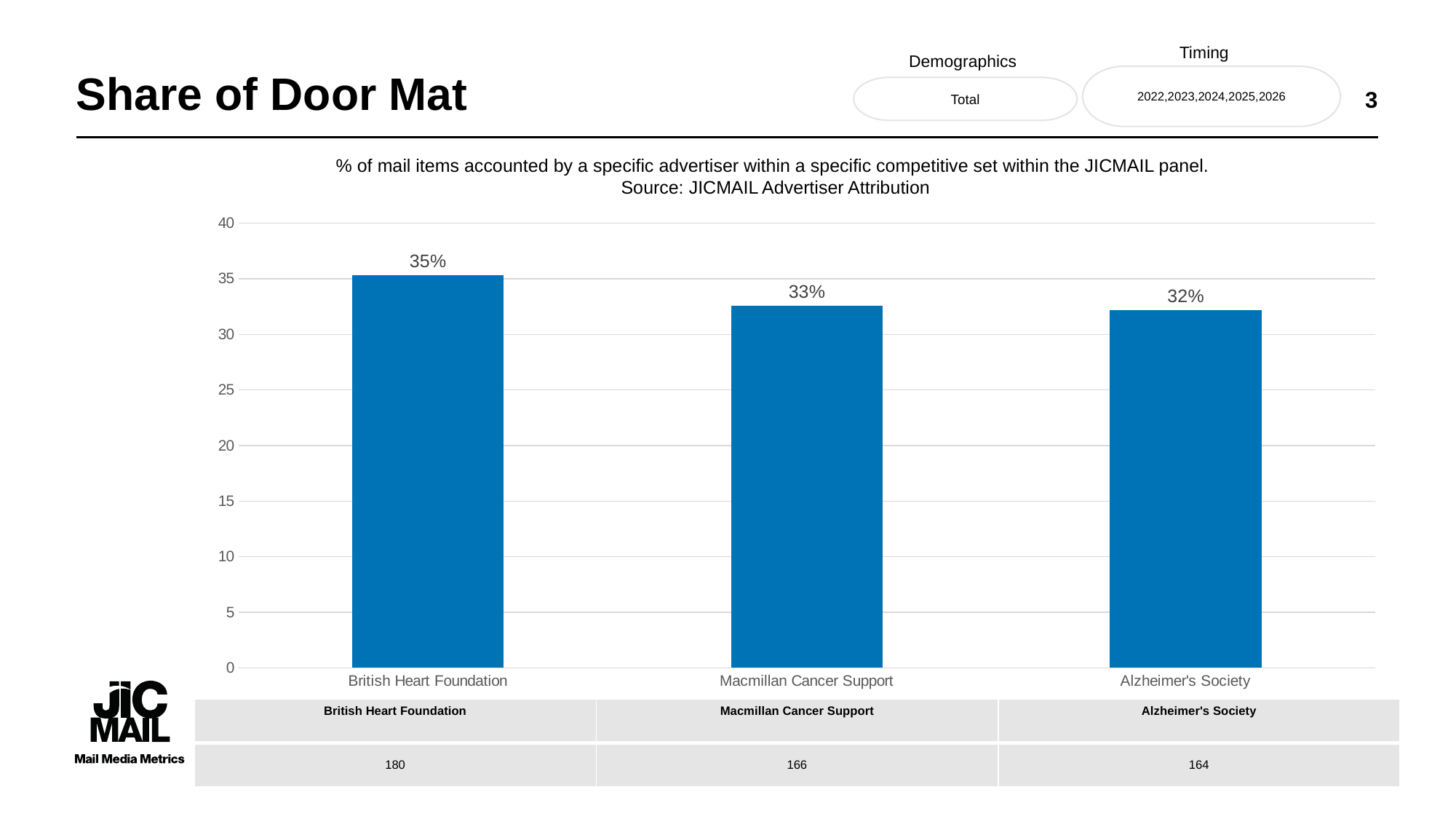
What kind of chart is shown on the slide? bar chart What is the value for British Heart Foundation? 35% Which advertiser has the lowest share of door mat? Alzheimer's Society What is the value for Alzheimer's Society? 32% Do the values rise or fall from left to right across the chart? fall Which advertiser has the highest share of door mat? British Heart Foundation What is the difference between the values for British Heart Foundation and Alzheimer's Society? 3% Which is larger, the value for British Heart Foundation or the value for Macmillan Cancer Support? British Heart Foundation Is the value for Macmillan Cancer Support greater or less than 30? greater What is the title of the slide? Share of Door Mat What is the value for Macmillan Cancer Support? 33% How many advertisers are shown in the chart? 3